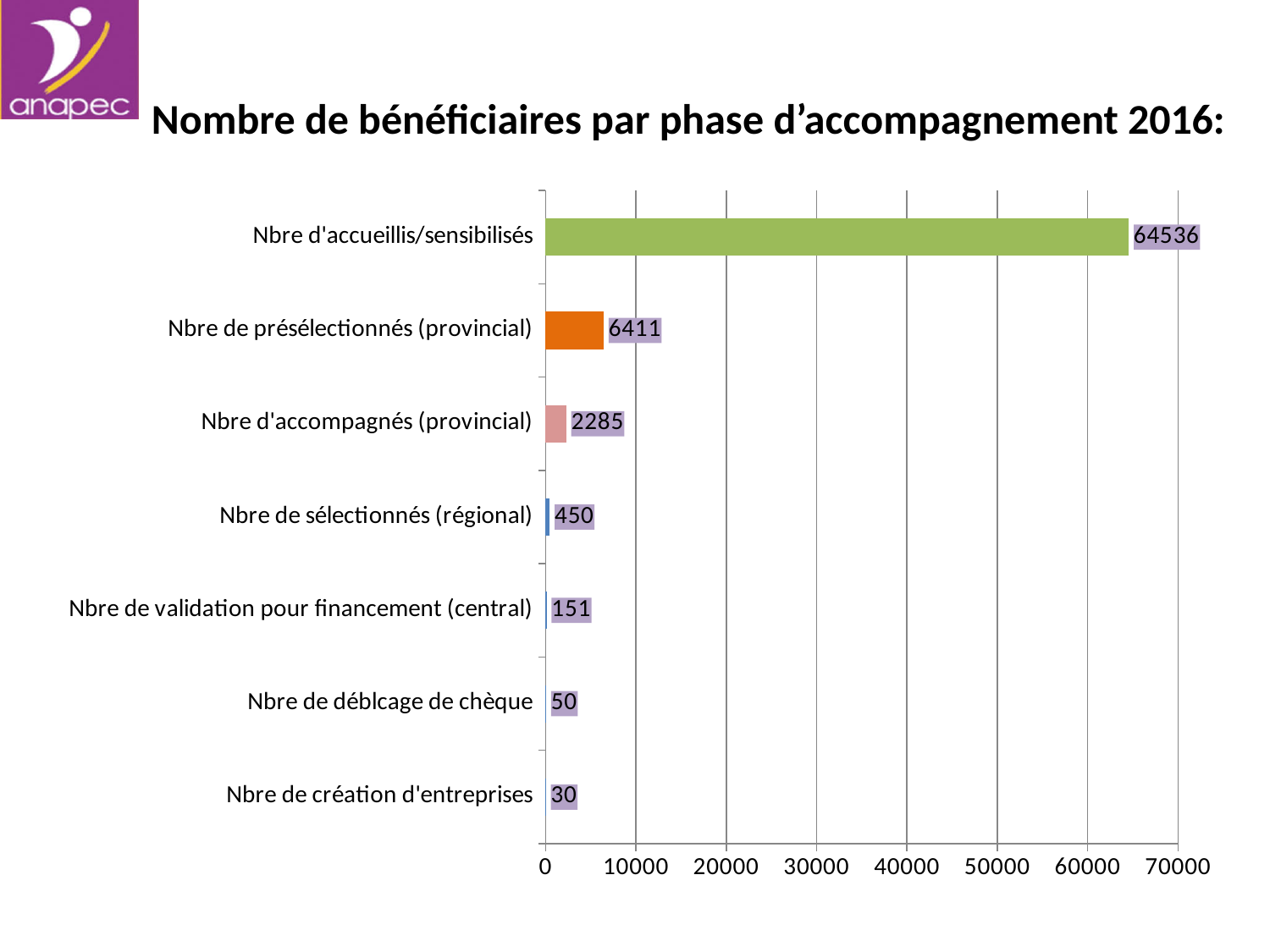
Which category has the lowest value? Nbre de création d'entreprises What is the value for Nbre de création d'entreprises? 30 What kind of chart is shown on the slide? bar chart What is the title of the chart? Nombre de bénéficiaires par phase d'accompagnement 2016: How many categories are shown in the chart? 7 Which is larger: Nbre de sélectionnés (régional) or Nbre de validation pour financement (central)? Nbre de sélectionnés (régional) What is the value for Nbre d'accompagnés (provincial)? 2285 Which category has the highest value? Nbre d'accueillis/sensibilisés Is the value for Nbre d'accueillis/sensibilisés greater or less than 60000? greater What is the value for Nbre de présélectionnés (provincial)? 6411 What is the value for Nbre d'accueillis/sensibilisés? 64536 What is the difference between Nbre de présélectionnés (provincial) and Nbre d'accompagnés (provincial)? 4126